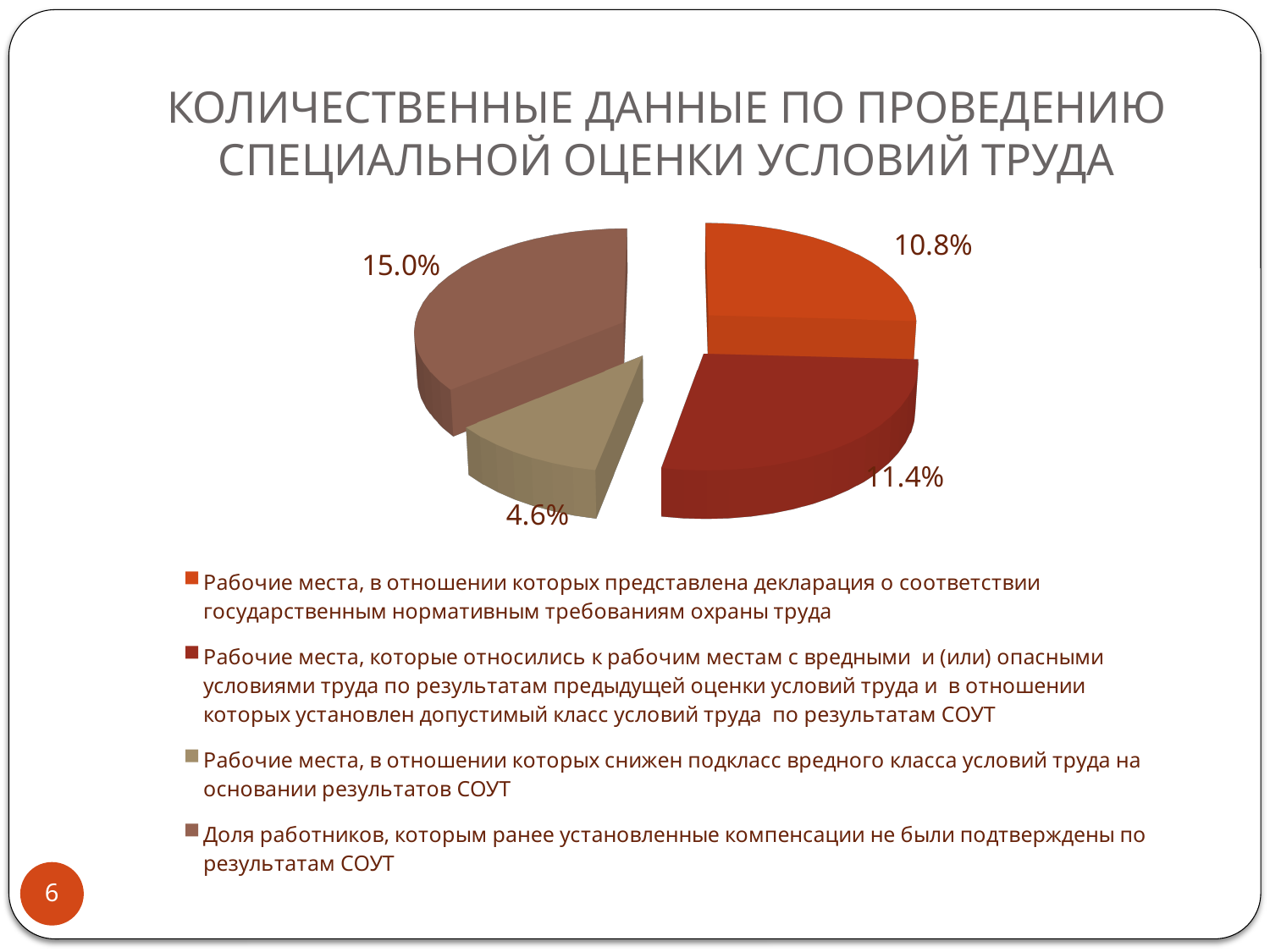
Which is larger: the slice for workplaces with a declaration of conformity (10.8%) or the slice for workplaces assigned an acceptable class by SOUT results (11.4%)? Рабочие места, которые относились к рабочим местам с вредными и (или) опасными условиями труда... (11.4%) What value is shown for the slice describing workplaces that previously had harmful and/or dangerous conditions and were assigned an acceptable class by the SOUT results? 11.4% What value is shown for the slice 'Рабочие места, в отношении которых представлена декларация о соответствии государственным нормативным требованиям охраны труда'? 10.8% Which slice of the pie chart has the smallest value? Рабочие места, в отношении которых снижен подкласс вредного класса условий труда на основании результатов СОУТ What type of chart is shown on the slide? Pie chart What is the difference between the 15.0% slice and the 4.6% slice? 10.4% What value is shown for the slice 'Доля работников, которым ранее установленные компенсации не были подтверждены по результатам СОУТ'? 15.0% What is the title of the chart slide? КОЛИЧЕСТВЕННЫЕ ДАННЫЕ ПО ПРОВЕДЕНИЮ СПЕЦИАЛЬНОЙ ОЦЕНКИ УСЛОВИЙ ТРУДА What value is shown for the slice 'Рабочие места, в отношении которых снижен подкласс вредного класса условий труда на основании результатов СОУТ'? 4.6% Which slice of the pie chart has the largest value? Доля работников, которым ранее установленные компенсации не были подтверждены по результатам СОУТ How many slices does the pie chart have? 4 How many entries does the legend of the pie chart list? 4